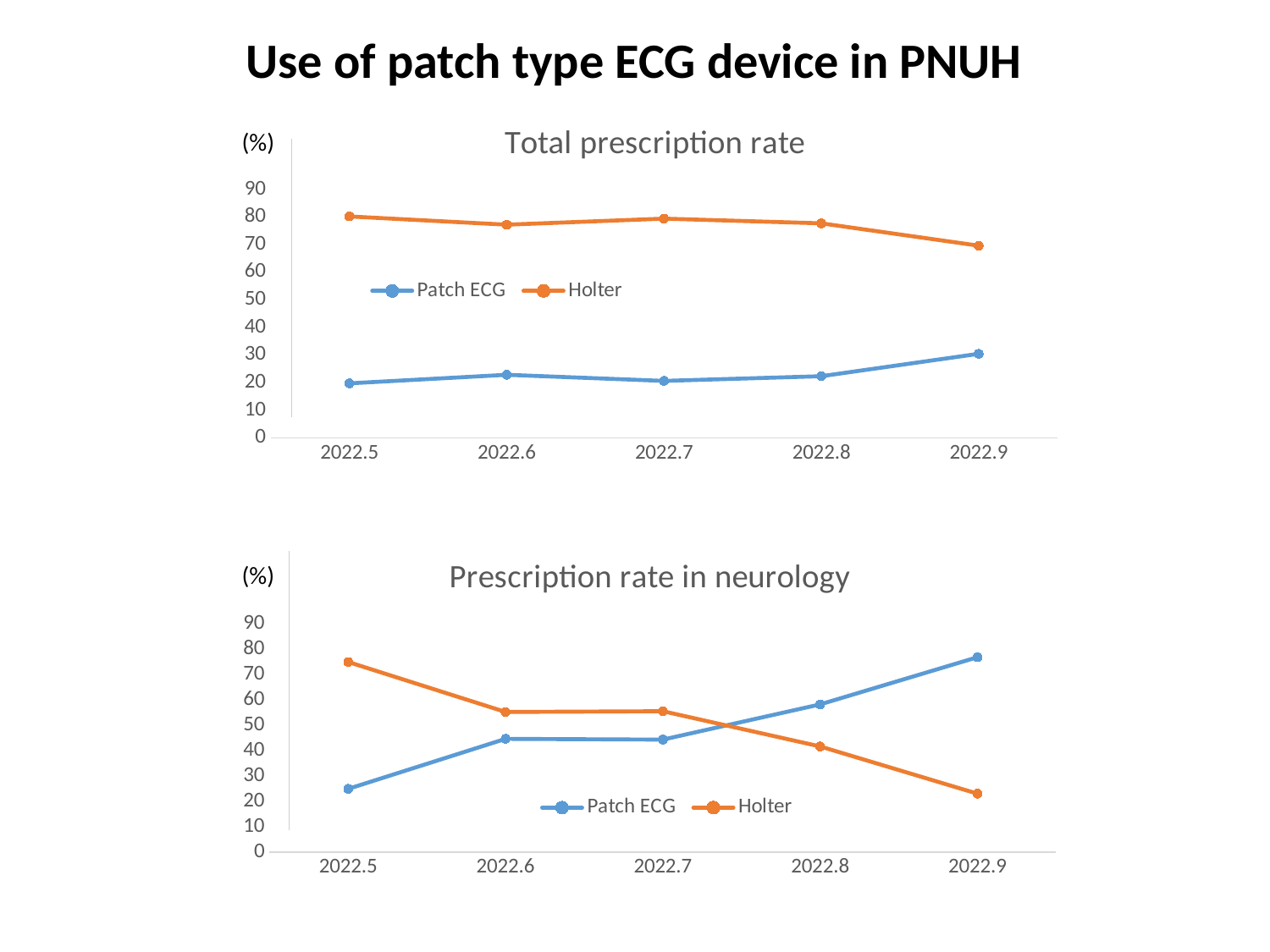
In the 'Prescription rate in neurology' chart, does the Holter series rise or fall from 2022.5 to 2022.9? fall In the 'Total prescription rate' chart, how many series does the legend list? 2 In the 'Prescription rate in neurology' chart, which series has the larger value at 2022.9, Patch ECG or Holter? Patch ECG In the 'Total prescription rate' chart, at which time point is the Holter value lowest? 2022.9 In the 'Total prescription rate' chart, at which time point is the Patch ECG value highest? 2022.9 In the 'Total prescription rate' chart, how many time points are plotted along the x axis? 5 In the 'Total prescription rate' chart, is the Patch ECG value for 2022.9 greater or less than 40? less In the 'Total prescription rate' chart, which series has the larger value at 2022.5, Patch ECG or Holter? Holter In the 'Total prescription rate' chart, is the Holter value for 2022.9 greater or less than 60? greater In the 'Prescription rate in neurology' chart, is the Patch ECG value for 2022.5 greater or less than 30? less What kind of chart is the 'Total prescription rate' chart? line chart What are the two legend entries in the 'Prescription rate in neurology' chart? Patch ECG and Holter